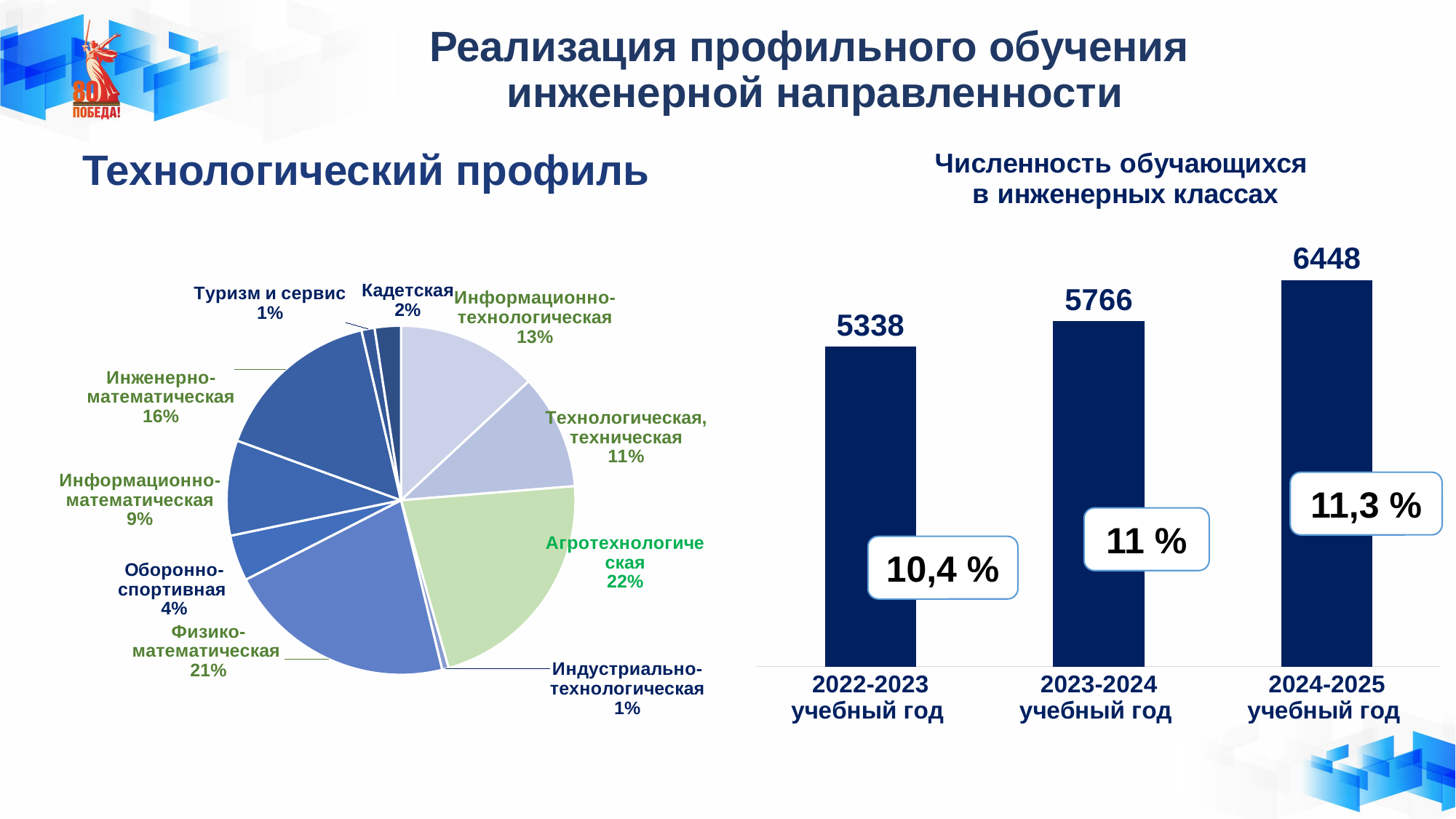
In the pie chart 'Технологический профиль', what is the difference between the shares of 'Физико-математическая' and 'Информационно-математическая'? 12% In the chart 'Численность обучающихся в инженерных классах', what is the difference between the values for '2024-2025 учебный год' and '2022-2023 учебный год'? 1110 In the chart 'Численность обучающихся в инженерных классах', what percentage is shown in the box on the bar for '2022-2023 учебный год'? 10,4 % In the pie chart 'Технологический профиль', what share does 'Агротехнологическая' have? 22% In the chart 'Численность обучающихся в инженерных классах', do the values rise or fall from 2022-2023 to 2024-2025? Rise What kind of chart is 'Численность обучающихся в инженерных классах'? Bar chart In the pie chart 'Технологический профиль', which is larger: 'Информационно-технологическая' or 'Технологическая, техническая'? Информационно-технологическая In the pie chart 'Технологический профиль', which category has the largest share? Агротехнологическая In the pie chart 'Технологический профиль', what share does 'Инженерно-математическая' have? 16% In the chart 'Численность обучающихся в инженерных классах', what is the value for '2023-2024 учебный год'? 5766 In the pie chart 'Технологический профиль', how many categories are shown? 10 In the chart 'Численность обучающихся в инженерных классах', which year has the highest value? 2024-2025 учебный год